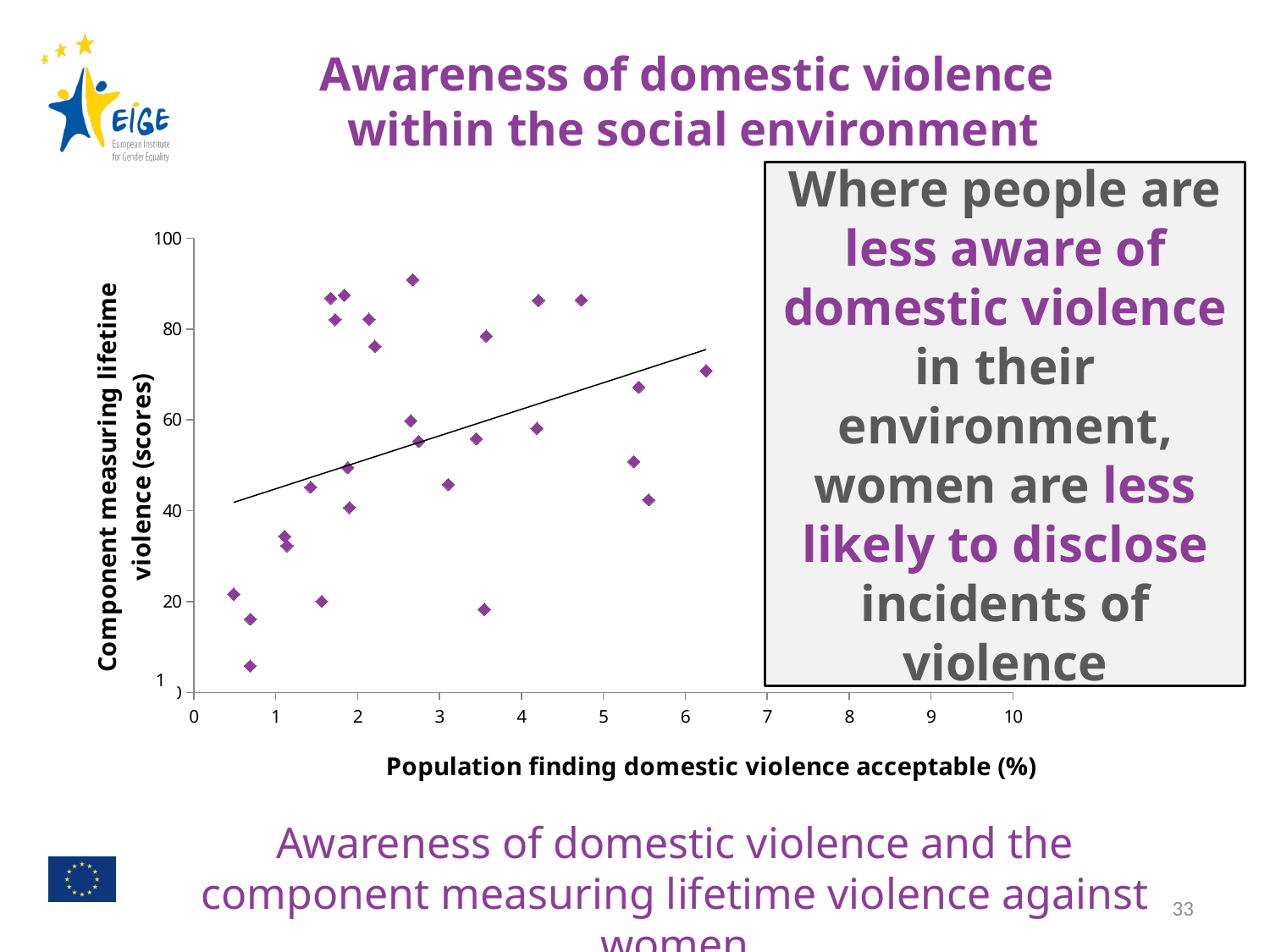
Is the highest plotted point on the chart greater or less than 80 on the y axis? greater Is the largest x-axis value among the plotted points greater or less than 7? less What is the title of the x axis of the chart? Population finding domestic violence acceptable (%) What is the title of the y axis of the chart? Component measuring lifetime violence (scores) Does the fitted trend line in the chart rise or fall as the x-axis value increases? rise What kind of chart is shown on the slide? scatter plot What is the maximum value shown on the y axis of the chart? 100 Is the y value of the trend line at x = 1 greater or less than 60? less What is the maximum value shown on the x axis of the chart? 10